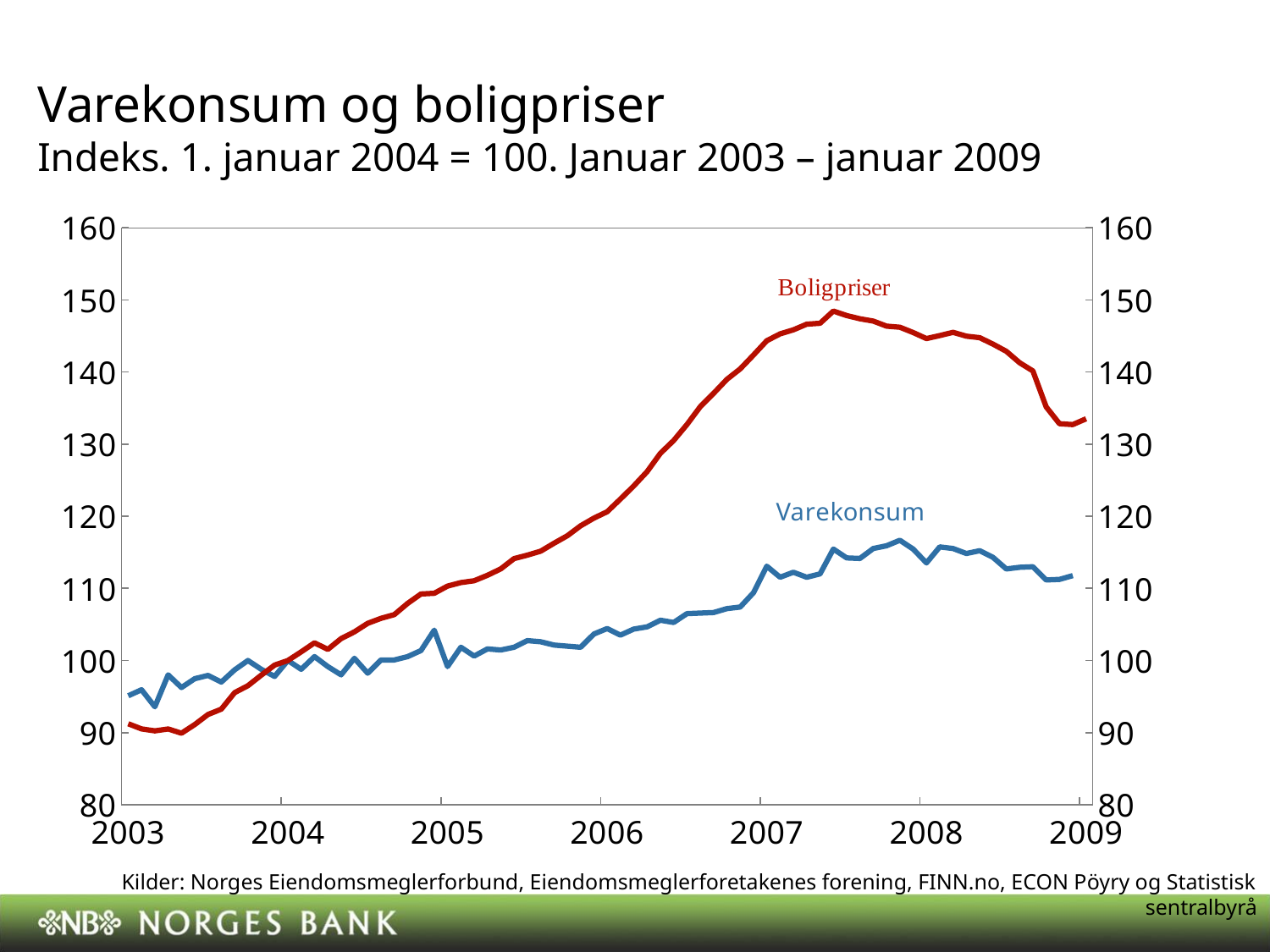
Which colour is the Boligpriser line? red What kind of chart is shown on the slide? line chart Does the Boligpriser line rise or fall between 2003 and 2007? rise Is the value of Varekonsum at January 2009 greater or less than 110? greater Does the Boligpriser line rise or fall between 2008 and 2009? fall Is the peak value of Boligpriser greater or less than 150? less At January 2009, which series has the higher value, Boligpriser or Varekonsum? Boligpriser Is the highest value of Varekonsum greater or less than 120? less How many series are plotted on the chart? 2 What is the title of the chart? Varekonsum og boligpriser